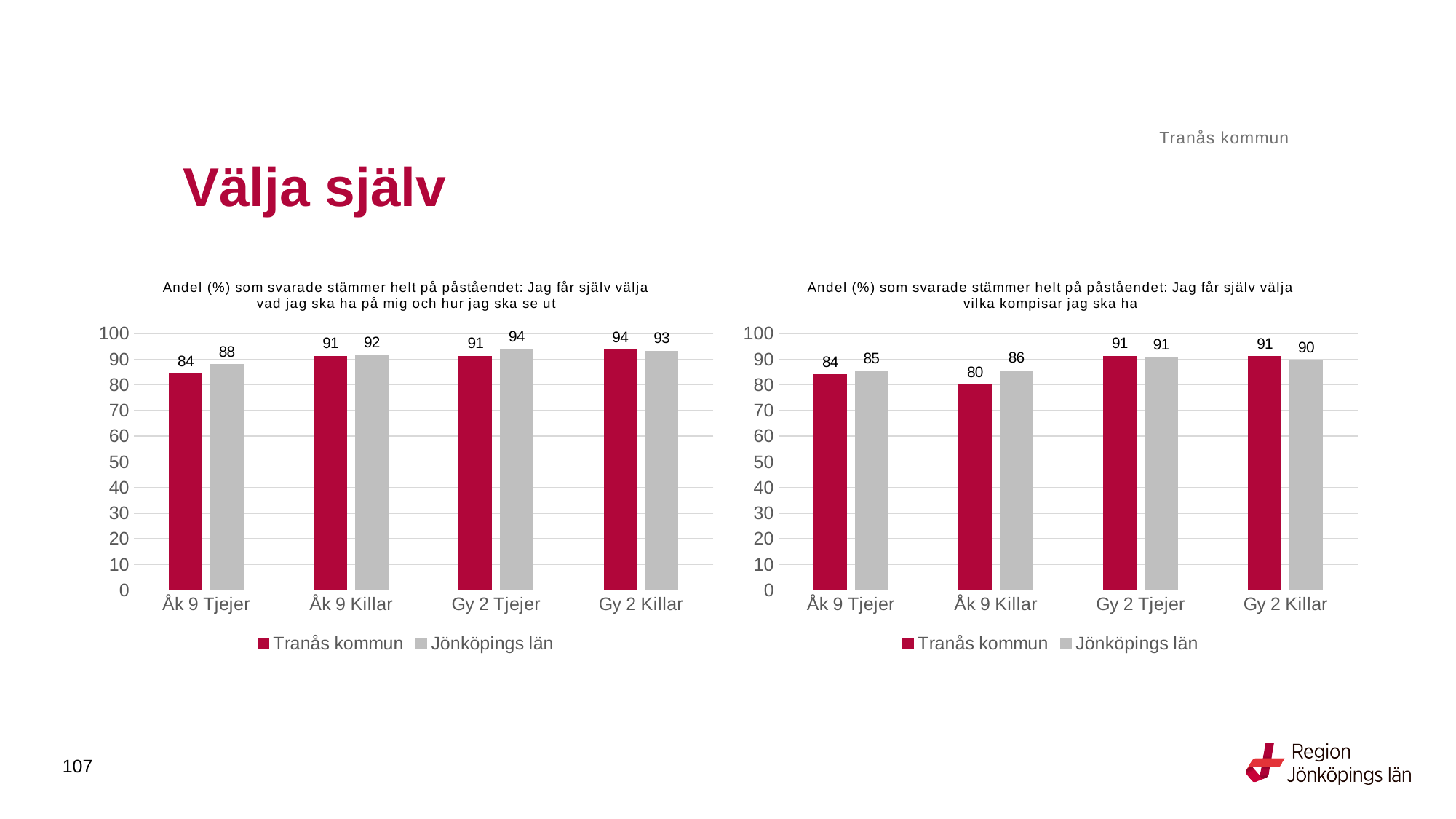
What kind of chart is the right chart? Bar chart In the left chart, which category has the highest value for Tranås kommun? Gy 2 Killar In the left chart, what is the difference between Jönköpings län and Tranås kommun for Åk 9 Tjejer? 4 In the right chart, what is the value for Jönköpings län for Gy 2 Killar? 90 In the right chart, what is the value for Tranås kommun for Åk 9 Killar? 80 In the right chart, what is the difference between Jönköpings län and Tranås kommun for Åk 9 Killar? 6 How many series does the legend of the left chart list? 2 In the left chart, what is the value for Jönköpings län for Gy 2 Tjejer? 94 How many categories are shown on the x axis of the right chart? 4 In the right chart, which category has the lowest value for Tranås kommun? Åk 9 Killar In the left chart, what is the value for Tranås kommun for Åk 9 Tjejer? 84 In the left chart, which is larger for Gy 2 Killar: Tranås kommun or Jönköpings län? Tranås kommun